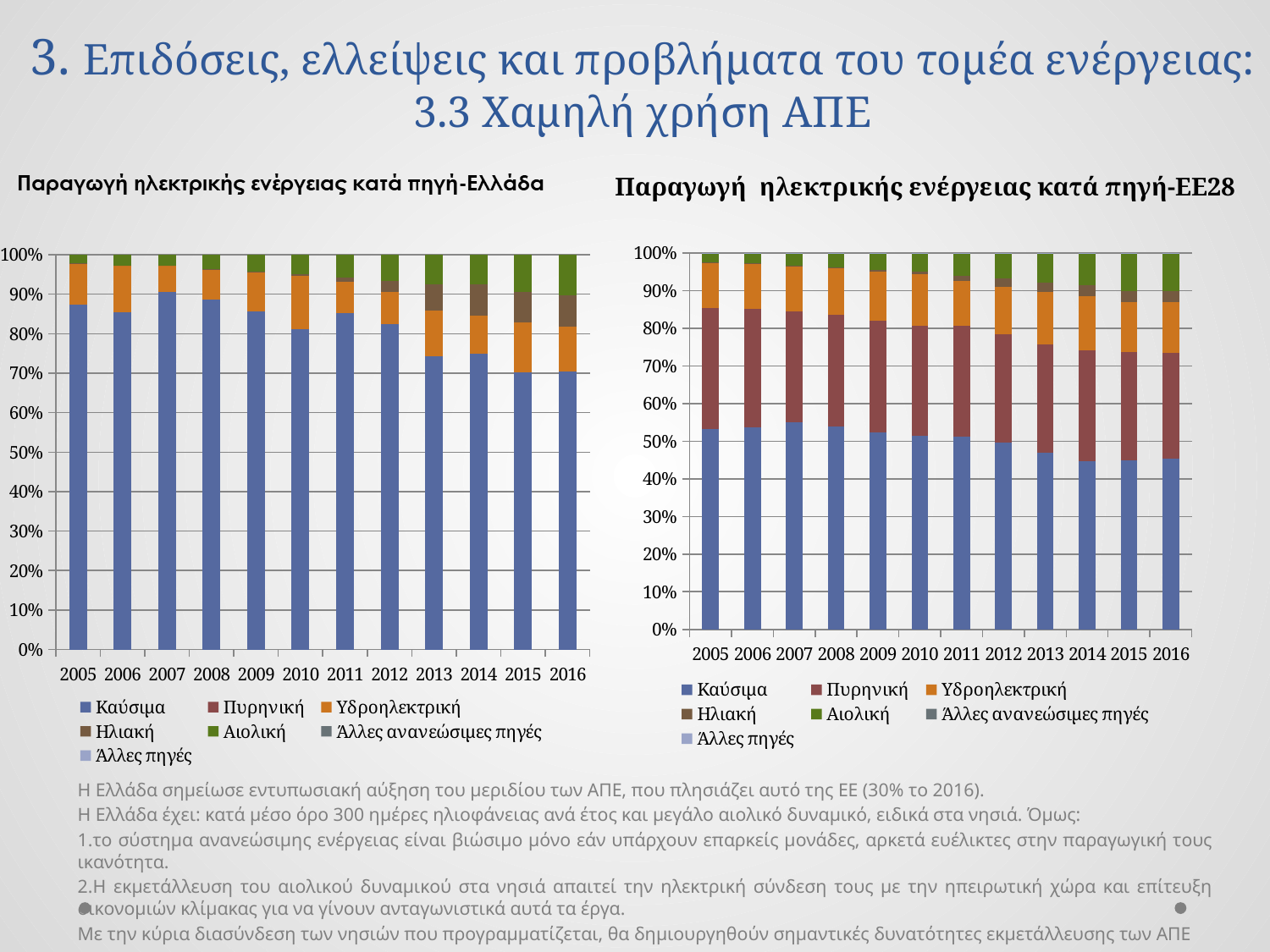
In the left chart (Ελλάδα), does the share of Καύσιμα rise or fall from 2005 to 2016? fall In the right chart (ΕΕ28), is the share of Καύσιμα in 2005 greater or less than 50%? greater Comparing the two charts for 2016, is the share of Καύσιμα larger in the Ελλάδα chart or the ΕΕ28 chart? Ελλάδα In the left chart (Ελλάδα), is the share of Καύσιμα larger in 2007 or in 2016? 2007 How many series does the legend of the left chart (Ελλάδα) list? 7 How many years are shown on the x axis of the right chart, 'Παραγωγή ηλεκτρικής ενέργειας κατά πηγή-ΕΕ28'? 12 In the left chart (Ελλάδα), is the share of Καύσιμα in 2016 greater or less than 80%? less In the right chart (ΕΕ28), is the share of Καύσιμα in 2016 greater or less than 50%? less In the right chart (ΕΕ28), does the share of Καύσιμα rise or fall from 2005 to 2016? fall What is the first year shown on the x axis of the left chart (Ελλάδα)? 2005 What kind of chart is the left chart, 'Παραγωγή ηλεκτρικής ενέργειας κατά πηγή-Ελλάδα'? Stacked bar chart